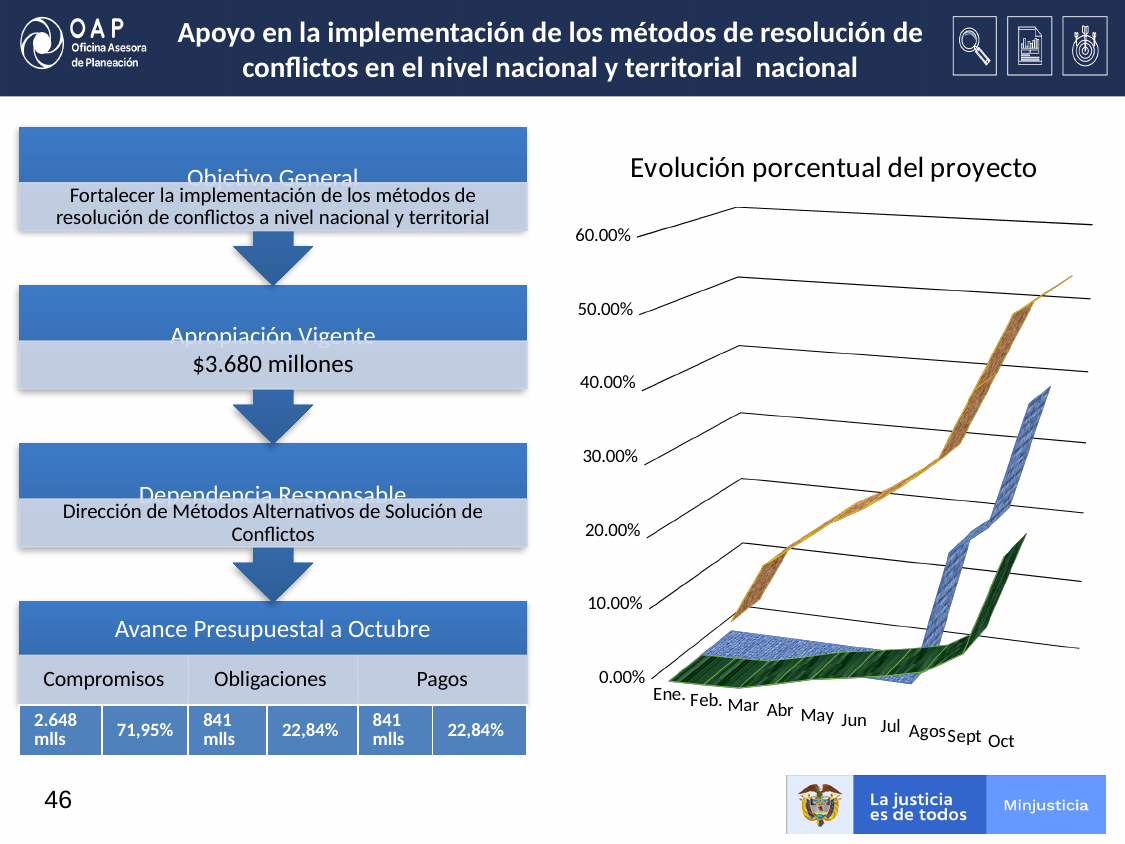
How many months are shown along the x axis of the chart? 10 What is the first category on the x axis of the chart? Ene. What kind of chart is shown on the slide? 3D line chart Does the orange series rise or fall from Ene. to Oct? rise What is the last category on the x axis of the chart? Oct What is the highest value shown on the y axis of the chart? 60.00% What is the title of the chart on the slide? Evolución porcentual del proyecto Which series reaches the highest value in Oct: the orange, blue or green one? orange Which series reaches the lowest value in Oct: the orange, blue or green one? green Does the green series rise or fall from Jul to Oct? rise